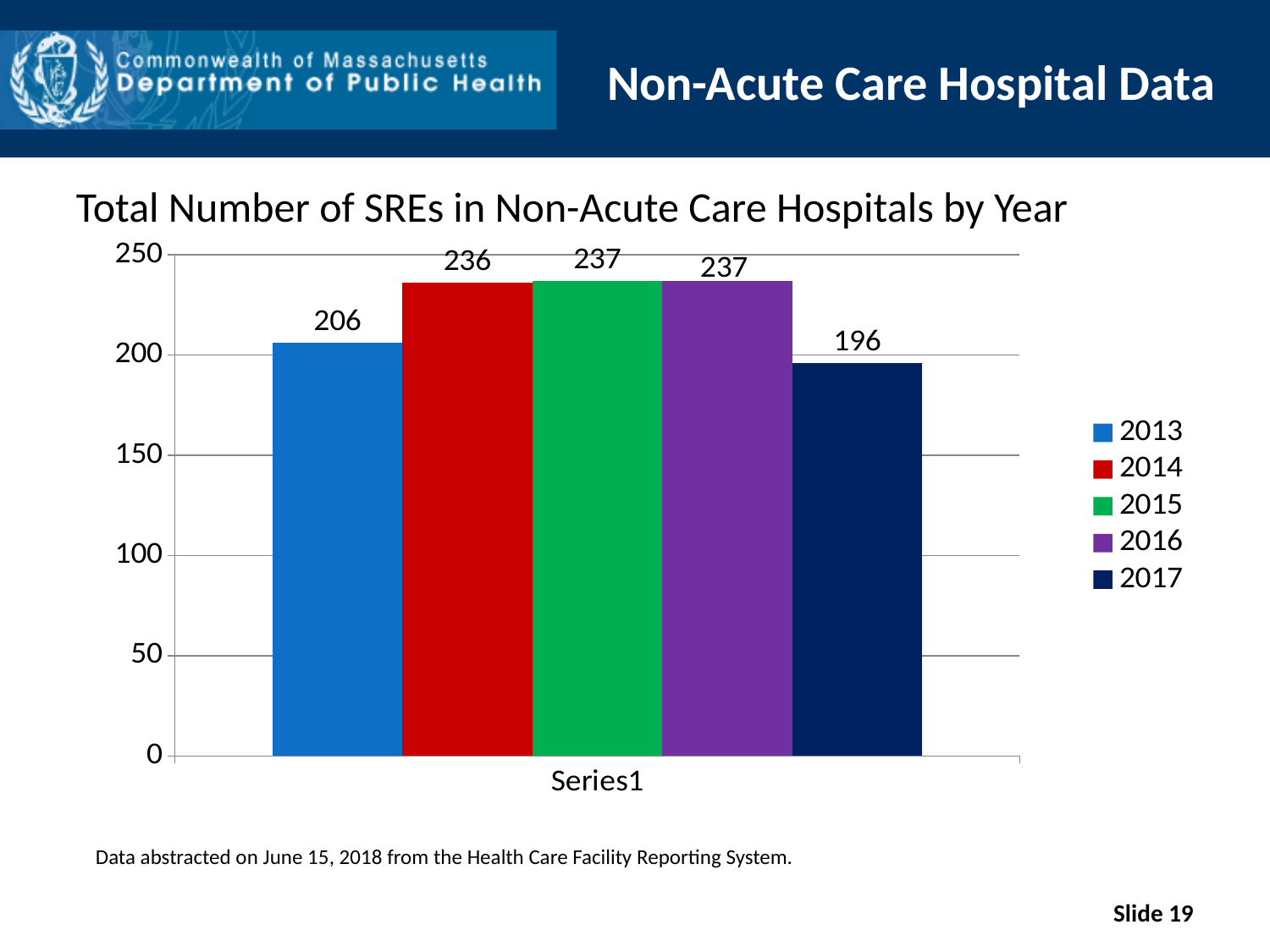
What is the total number of SREs in non-acute care hospitals for 2017? 196 Is the value for 2015 greater or less than 200? greater What is the title of the chart? Total Number of SREs in Non-Acute Care Hospitals by Year What kind of chart is shown on the slide? Bar chart Which is larger, the value for 2013 or the value for 2017? 2013 What is the difference between the number of SREs in 2016 and 2017? 41 What is the total number of SREs in non-acute care hospitals for 2013? 206 How many entries does the legend list? 5 Which year has the lowest number of SREs? 2017 How many years are shown in the chart? 5 What is the value shown for 2014? 236 What is the difference between the number of SREs in 2014 and 2013? 30